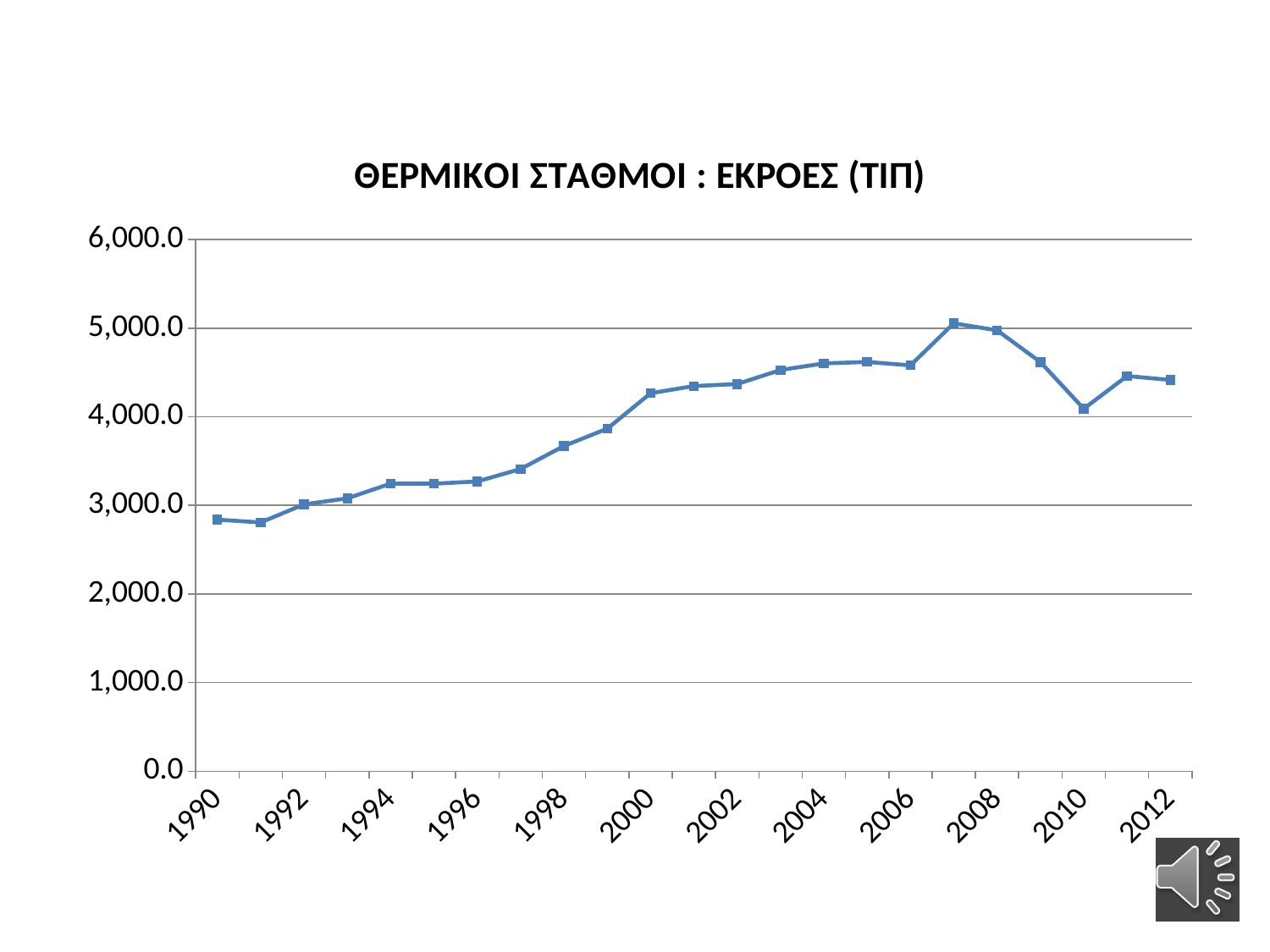
What kind of chart is shown on the slide? line chart Is the value for 1998 greater or less than 4,000.0? less Is the value for 2010 greater or less than 4,000.0? greater What is the title of the chart? ΘΕΡΜΙΚΟΙ ΣΤΑΘΜΟΙ : ΕΚΡΟΕΣ (ΤΙΠ) Do the values generally rise or fall from 1990 to 2007? rise Which year has the larger value, 2007 or 2010? 2007 How many data points are plotted on the chart (years 1990 to 2012)? 23 In which year does the line reach its highest value? 2007 Is the value for 2007 greater or less than 5,000.0? greater Which year has the larger value, 1990 or 2000? 2000